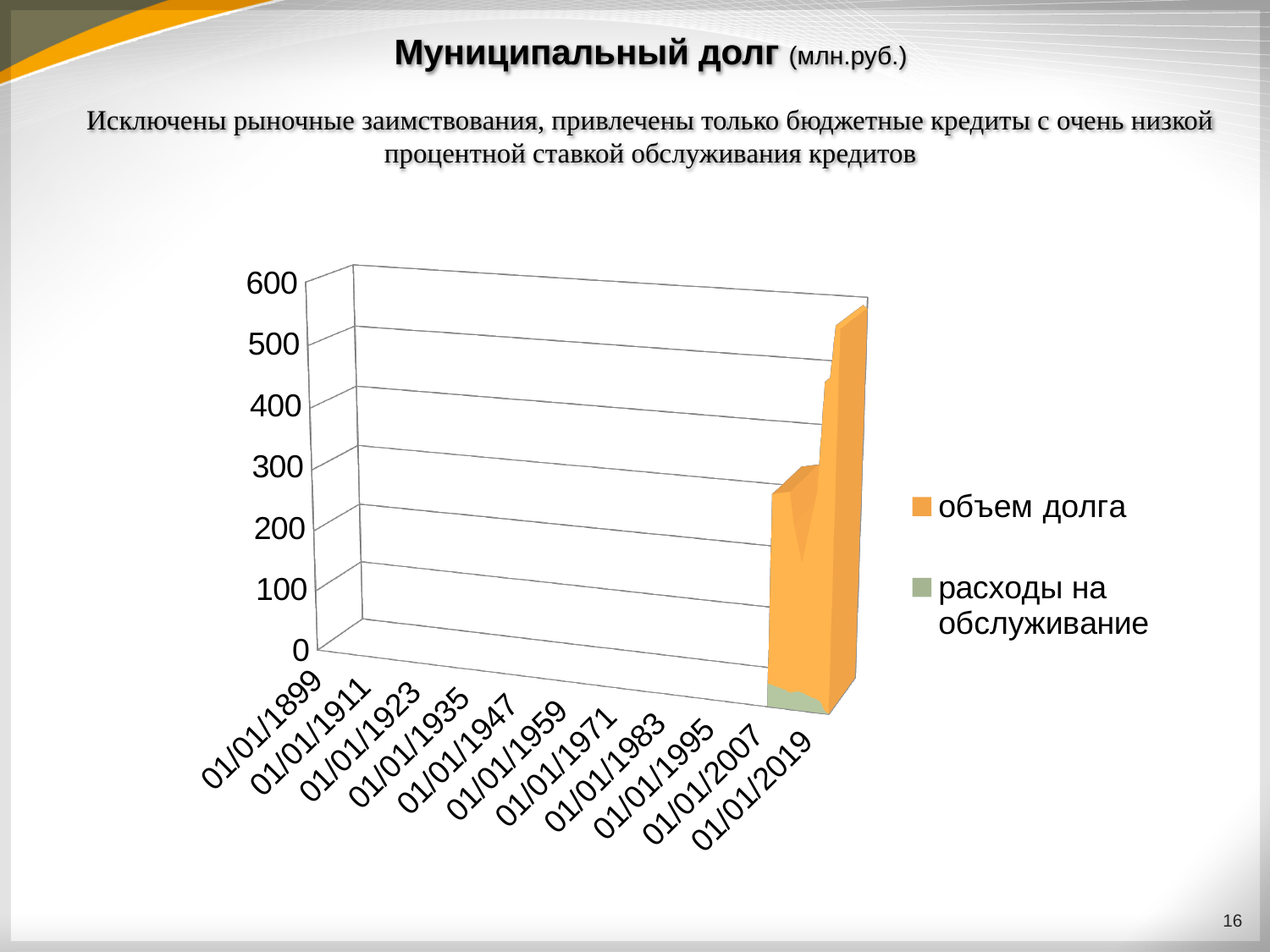
Which series reaches higher values, объем долга or расходы на обслуживание? объем долга How many series does the legend list? 2 How many date labels are shown on the x axis? 11 What is the first date label on the x axis? 01/01/1899 What is the title of the chart? Муниципальный долг (млн.руб.) What is the last date label on the x axis? 01/01/2019 Which series is shown in orange in the legend? объем долга Is the peak value of the объем долга series greater or less than 500? greater What is the highest value shown on the vertical axis? 600 Is the value of the расходы на обслуживание series greater or less than 100? less What kind of chart is shown on the slide? area chart In what units are the values on the chart given? млн.руб.